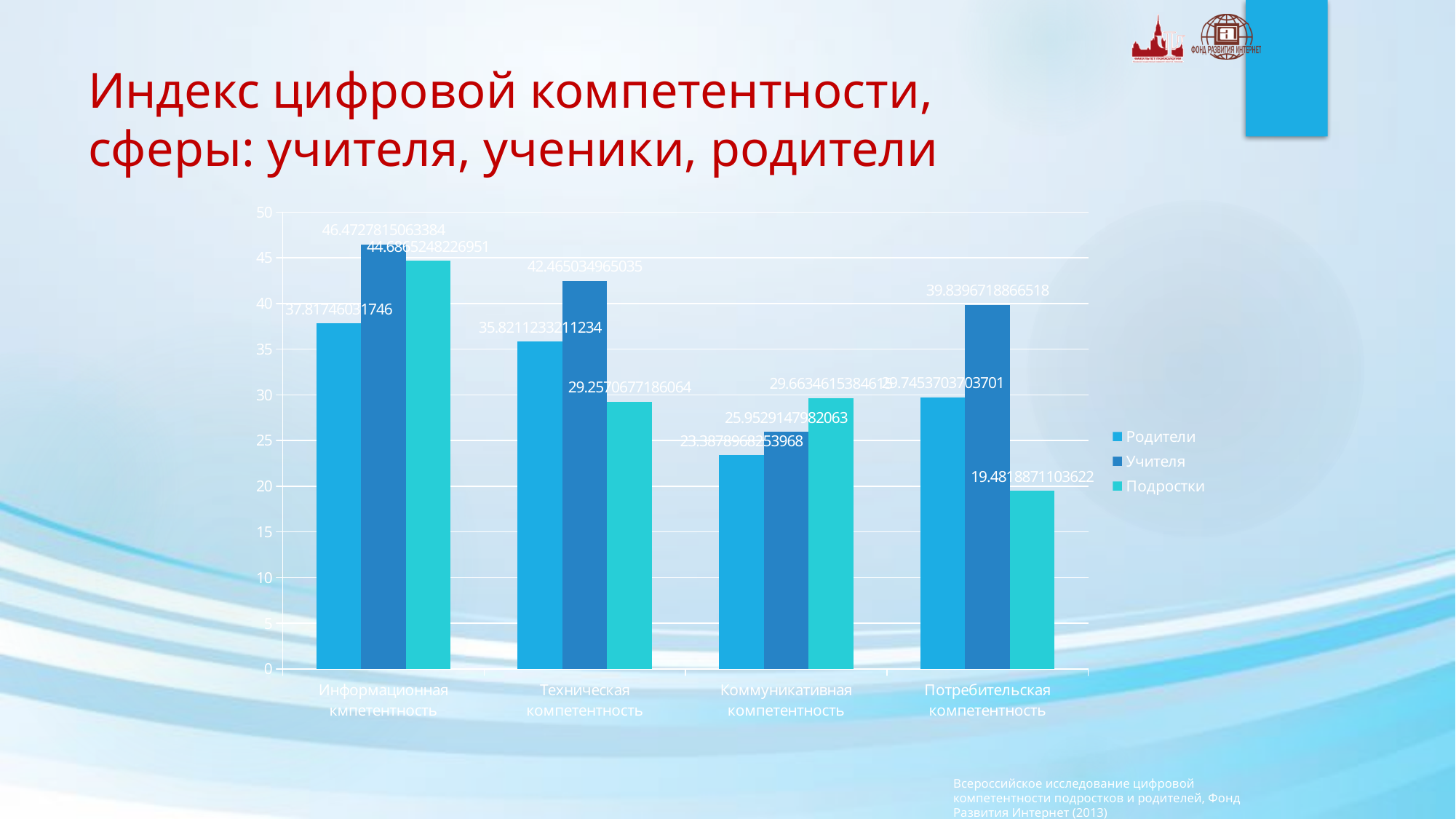
Which series has the lowest value in Потребительская компетентность? Подростки Which series has the highest value in Информационная компетентность? Учителя What is the value for Учителя in Информационная компетентность? 46.4727815063384 What kind of chart is shown on the slide? Bar chart What is the difference between the Учителя and Подростки values in Потребительская компетентность? 20.3577847762896 What is the value for Родители in Техническая компетентность? 35.8211233211234 In Техническая компетентность, which is larger: the value for Родители or the value for Подростки? Родители How many categories are shown on the x axis? 4 Is the value for Родители in Коммуникативная компетентность greater or less than 25? less What is the value for Подростки in Потребительская компетентность? 19.4818871103622 What is the value for Учителя in Техническая компетентность? 42.465034965035 How many series does the legend list? 3